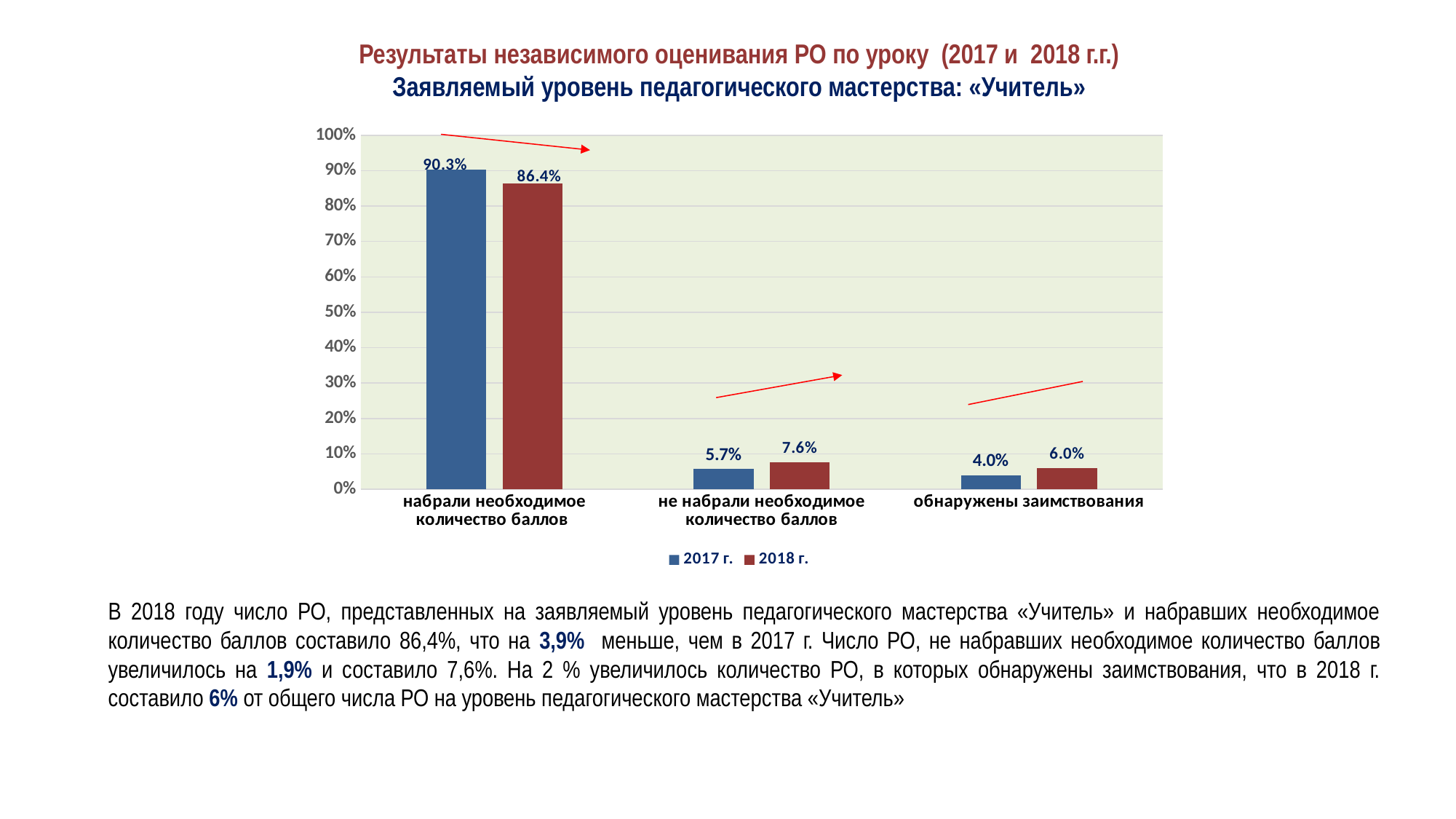
Which category has the highest value for 2018 г.? набрали необходимое количество баллов What is the value for 2017 г. in the category 'обнаружены заимствования'? 4.0% What is the value for 2018 г. in the category 'набрали необходимое количество баллов'? 86.4% What is the value for 2017 г. in the category 'набрали необходимое количество баллов'? 90.3% How many series does the legend list? 2 Is the value for 2018 г. in the category 'не набрали необходимое количество баллов' greater or less than 10%? less Which is larger in the category 'обнаружены заимствования': the value for 2017 г. or for 2018 г.? 2018 г. How many categories are shown on the x axis of the chart? 3 What kind of chart is shown on the slide? bar chart What is the difference between the 2017 г. and 2018 г. values in the category 'набрали необходимое количество баллов'? 3.9% Which category has the lowest value for 2017 г.? обнаружены заимствования What is the value for 2018 г. in the category 'не набрали необходимое количество баллов'? 7.6%